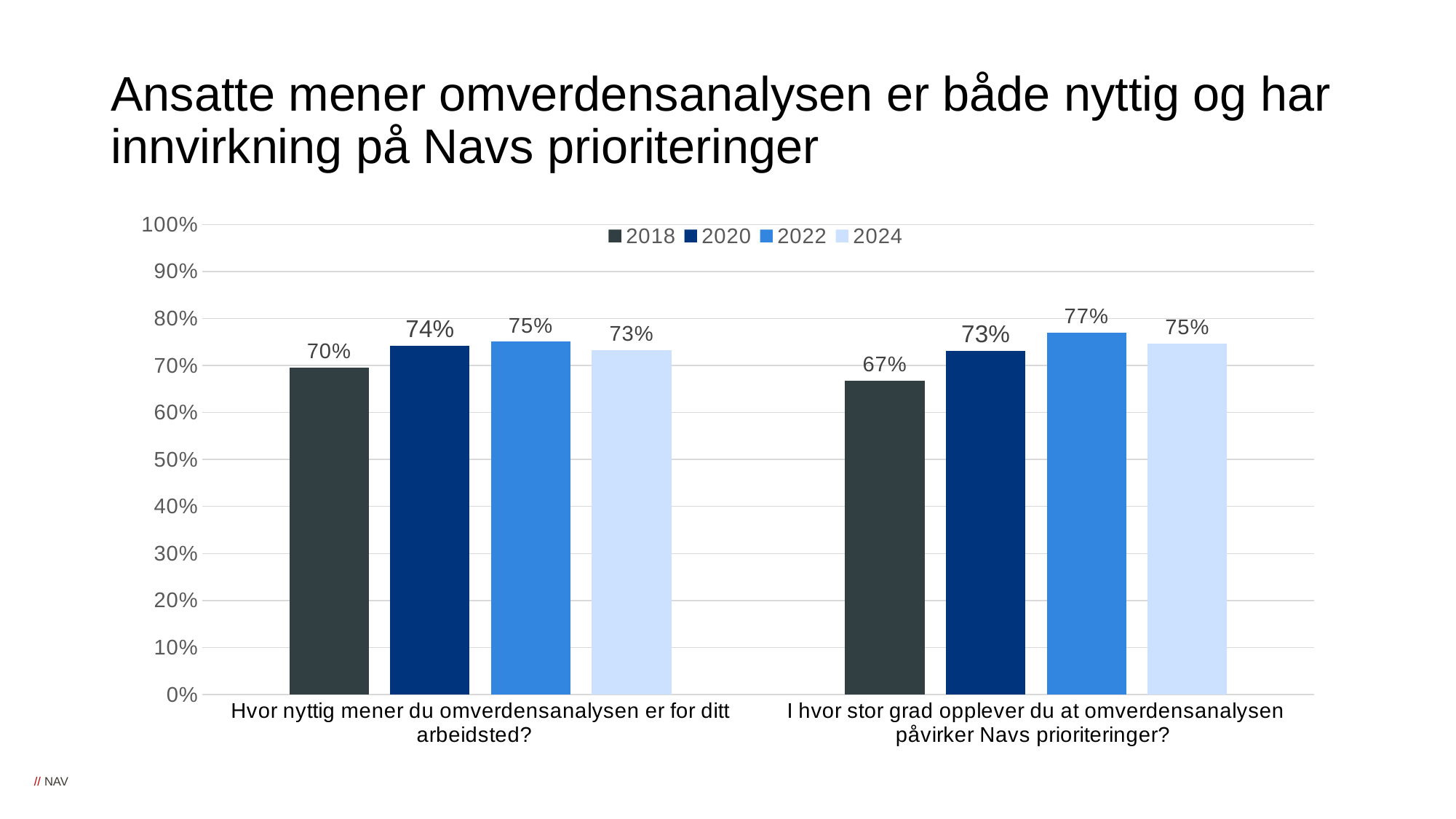
What is the difference between the 2022 and 2018 values for "I hvor stor grad opplever du at omverdensanalysen påvirker Navs prioriteringer?"? 10 percentage points What is the 2020 value for "I hvor stor grad opplever du at omverdensanalysen påvirker Navs prioriteringer?"? 73% What kind of chart is shown on the slide? Bar chart What is the 2018 value for "Hvor nyttig mener du omverdensanalysen er for ditt arbeidsted?"? 70% Which year has the lowest value for "Hvor nyttig mener du omverdensanalysen er for ditt arbeidsted?"? 2018 What is the 2024 value for "Hvor nyttig mener du omverdensanalysen er for ditt arbeidsted?"? 73% Which year has the highest value for "I hvor stor grad opplever du at omverdensanalysen påvirker Navs prioriteringer?"? 2022 How many series does the legend list? 4 Which is larger: the 2018 value for "Hvor nyttig mener du omverdensanalysen er for ditt arbeidsted?" or the 2018 value for "I hvor stor grad opplever du at omverdensanalysen påvirker Navs prioriteringer?"? Hvor nyttig mener du omverdensanalysen er for ditt arbeidsted? Which years are listed in the chart legend? 2018, 2020, 2022, 2024 How many categories are shown on the x axis? 2 What is the 2022 value for "I hvor stor grad opplever du at omverdensanalysen påvirker Navs prioriteringer?"? 77%